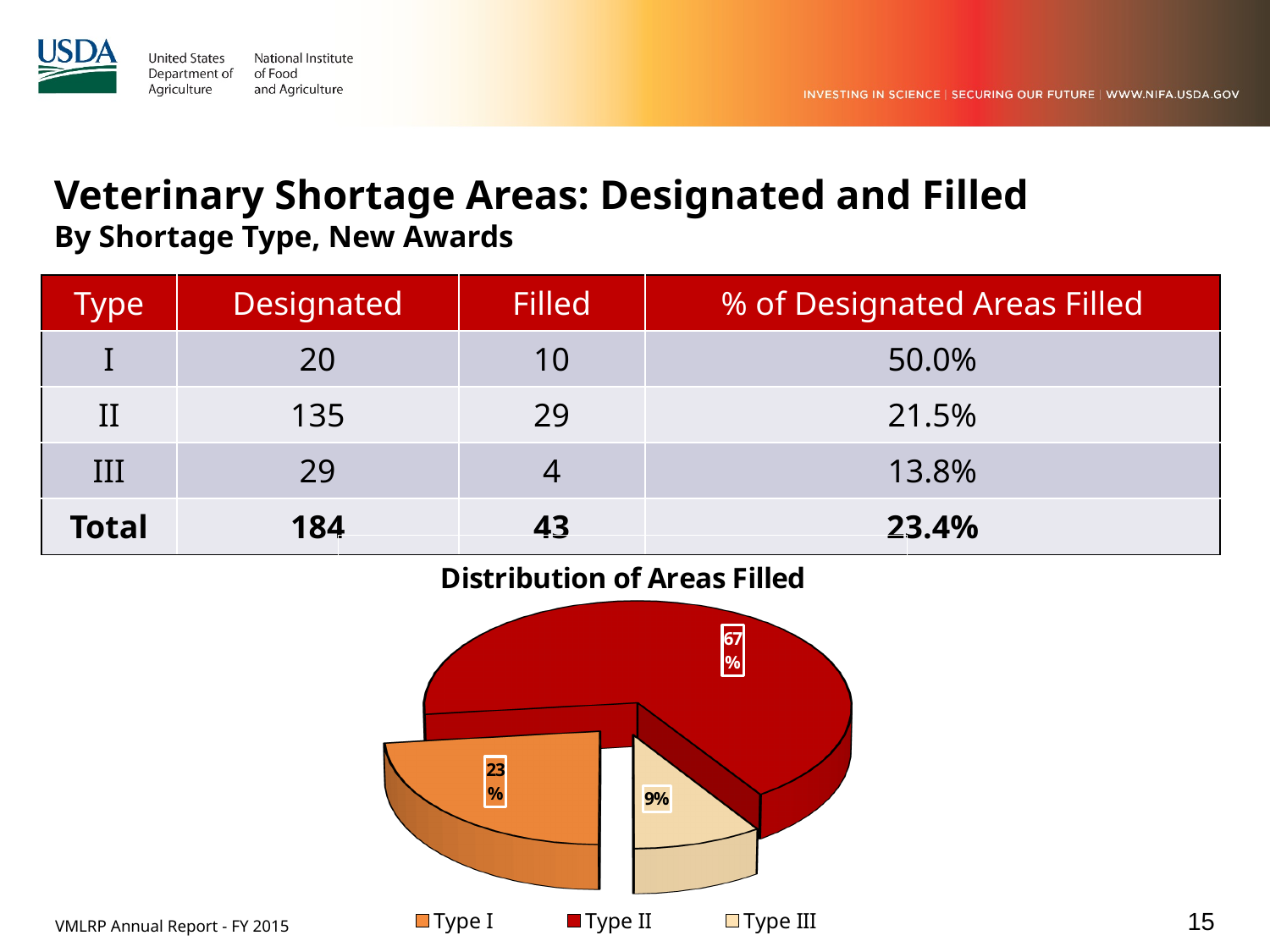
Which type has the largest slice in the Distribution of Areas Filled pie chart? Type II Which type has the smallest slice in the Distribution of Areas Filled pie chart? Type III In the Distribution of Areas Filled pie chart, which slice is larger: Type I or Type III? Type I In the Distribution of Areas Filled pie chart, what percentage is shown for Type III? 9% In the Distribution of Areas Filled pie chart, what percentage is shown for Type II? 67% What colour is the Type II slice in the Distribution of Areas Filled pie chart? red How many entries are listed in the legend of the Distribution of Areas Filled pie chart? 3 In the Distribution of Areas Filled pie chart, how many percentage points larger is the Type II slice than the Type I slice? 44 percentage points What kind of chart is shown under the table on the slide? pie chart What is the title of the pie chart? Distribution of Areas Filled How many slices does the Distribution of Areas Filled pie chart have? 3 In the Distribution of Areas Filled pie chart, what percentage is shown for Type I? 23%